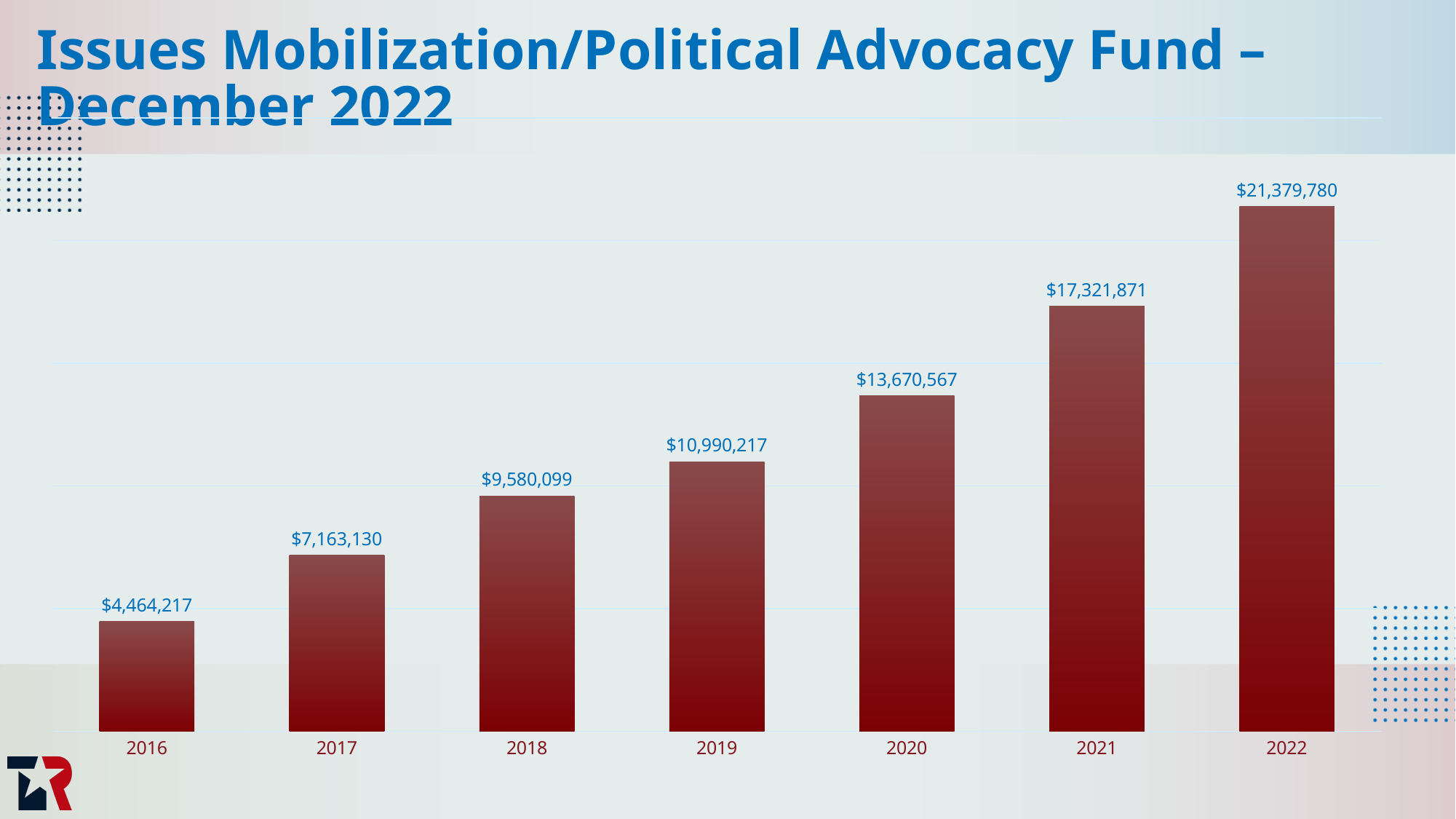
What is the difference between the values for 2017 and 2016? $2,698,913 What is the value for 2019? $10,990,217 What is the value for 2016? $4,464,217 Which is larger, the value for 2020 or the value for 2019? 2020 Which year has the highest value? 2022 What is the value for 2018? $9,580,099 Which year has the lowest value? 2016 What kind of chart is shown on the slide? Bar chart What is the difference between the values for 2022 and 2021? $4,057,909 Do the values rise or fall from 2016 to 2022? Rise What is the value for 2021? $17,321,871 How many years are shown on the chart? 7